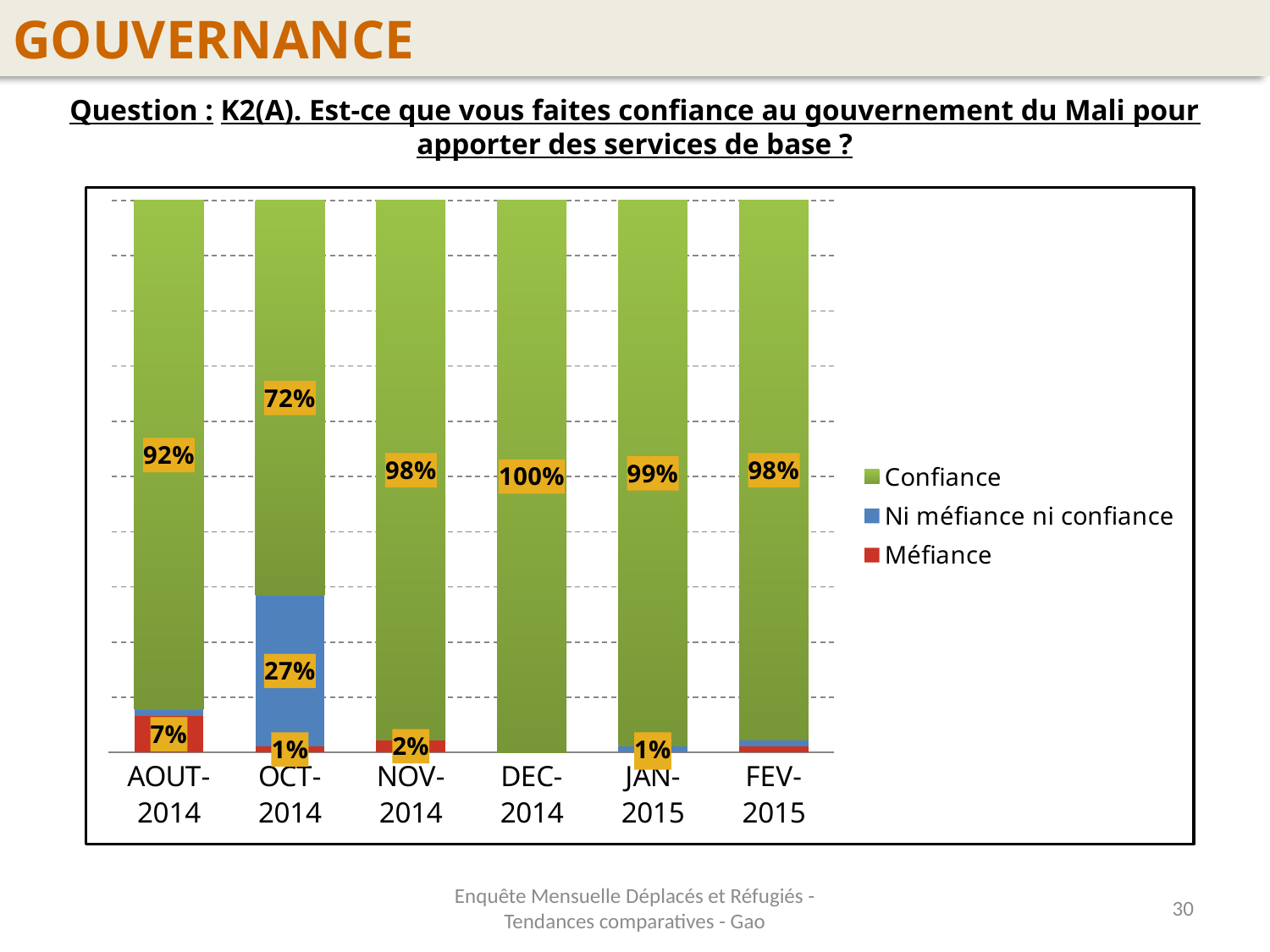
How many months (categories) are shown on the x axis? 6 Which month has the highest Confiance value? DEC-2014 What is the difference between the Confiance values for DEC-2014 and OCT-2014? 28% What is the Confiance value for OCT-2014? 72% What type of chart is shown on the slide? stacked bar chart What is the Confiance value for AOUT-2014? 92% How many series does the legend list? 3 Which series is shown in green in the legend? Confiance What is the Méfiance value for AOUT-2014? 7% Which month has the lowest Confiance value? OCT-2014 What is the Confiance value for DEC-2014? 100% What is the Ni méfiance ni confiance value for OCT-2014? 27%